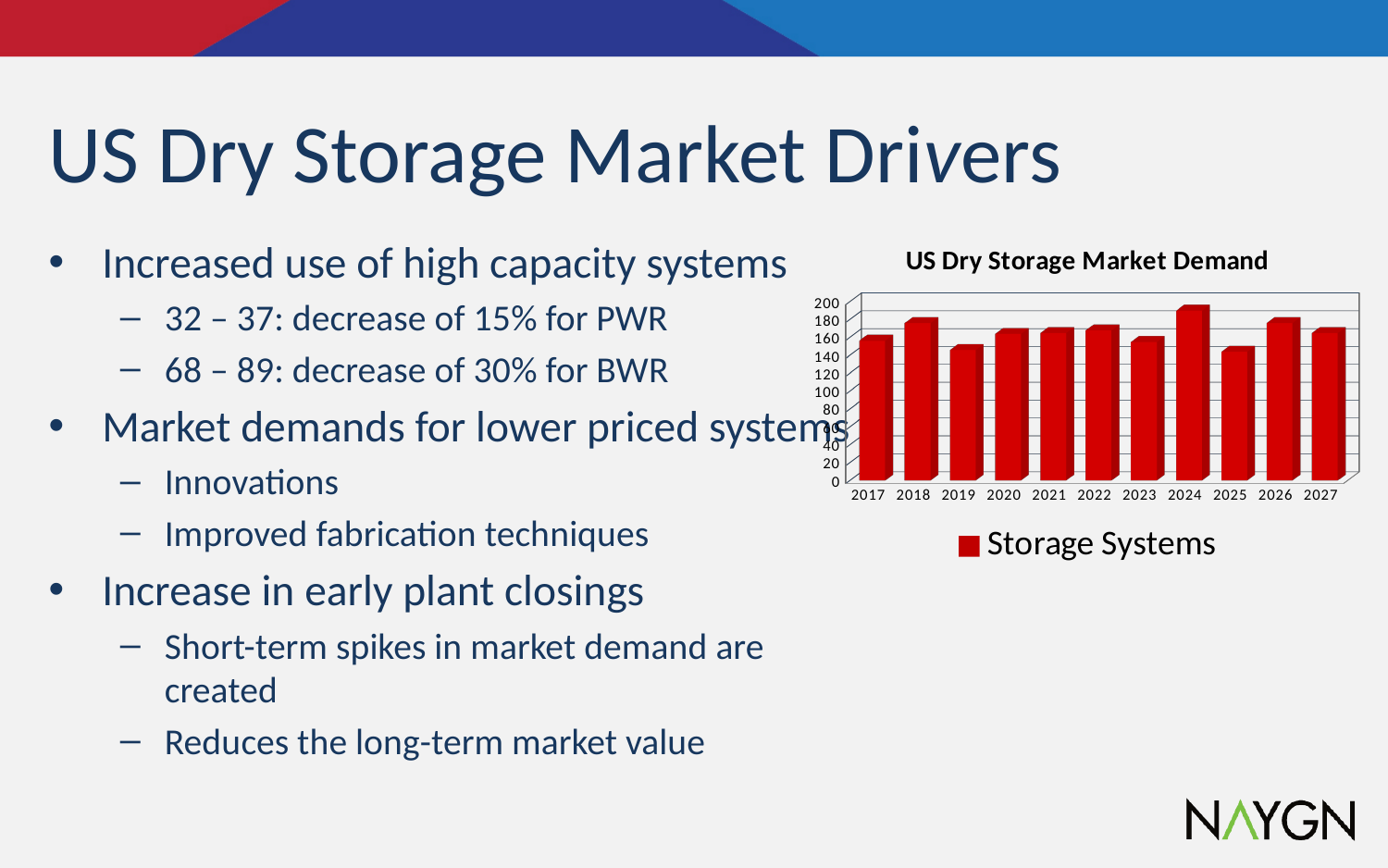
Is the value for 2018 greater or less than 160? greater Which is larger, the value for 2018 or the value for 2023? 2018 What is the name of the series shown in the chart legend? Storage Systems What is the title of the chart on the slide? US Dry Storage Market Demand Is the value for 2019 greater or less than 160? less Is the value for 2025 greater or less than 160? less Which year has the highest value in the chart? 2024 How many series does the chart legend list? 1 What type of chart is shown on the slide? bar chart Which is larger, the value for 2024 or the value for 2019? 2024 How many years are shown on the x axis of the chart? 11